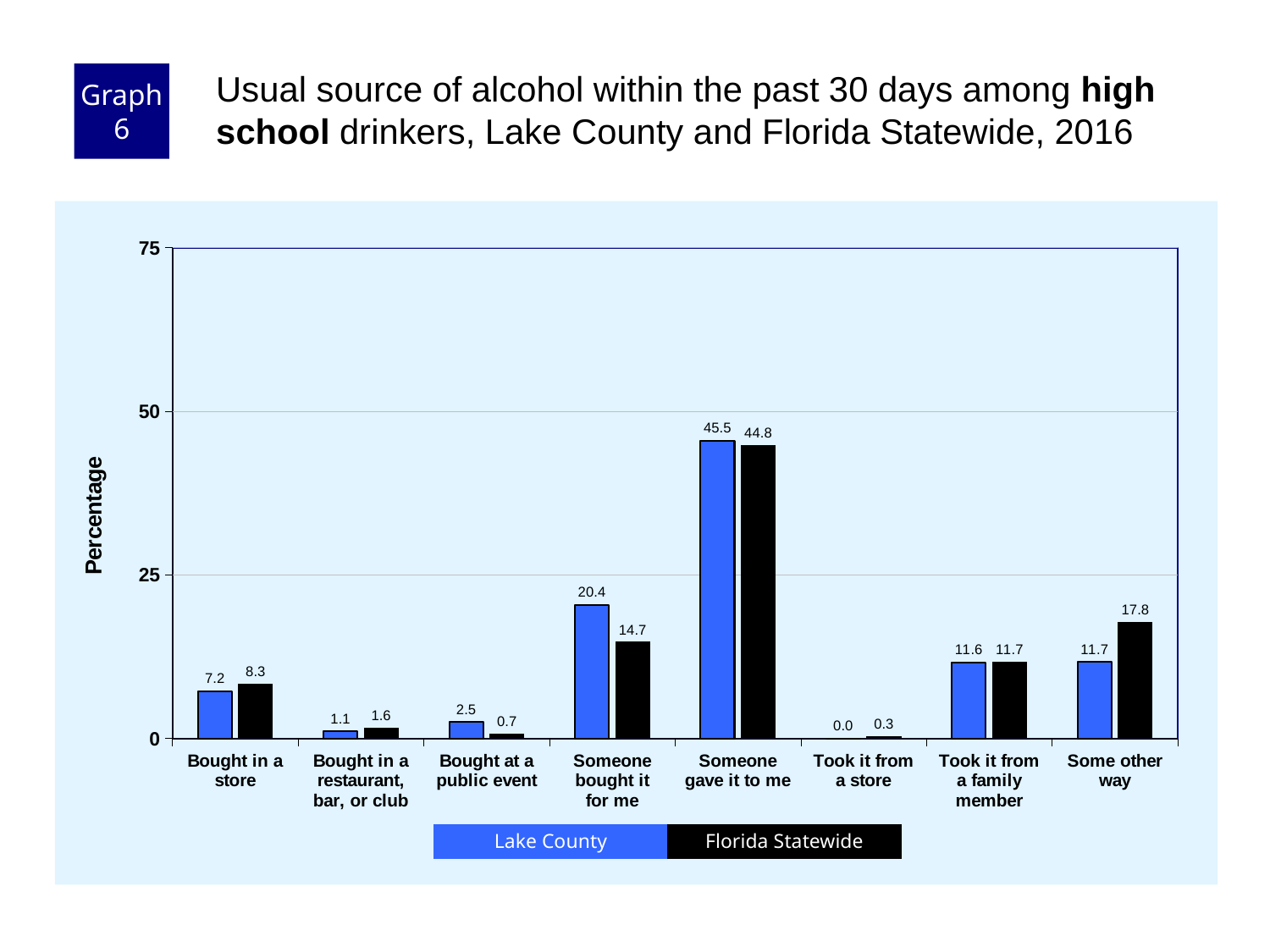
What is the Florida Statewide value for "Some other way"? 17.8 What is the label of the y axis? Percentage What kind of chart is shown on the slide? bar chart Which category has the lowest Lake County value? Took it from a store Which category has the highest Florida Statewide value? Someone gave it to me How many categories are shown on the x axis? 8 Which is larger for "Bought at a public event": Lake County or Florida Statewide? Lake County What is the Lake County value for "Took it from a store"? 0.0 What is the difference between the Lake County and Florida Statewide values for "Someone bought it for me"? 5.7 How many series does the legend list? 2 What is the Lake County value for "Someone gave it to me"? 45.5 Is the Florida Statewide value for "Someone gave it to me" greater or less than 50? less